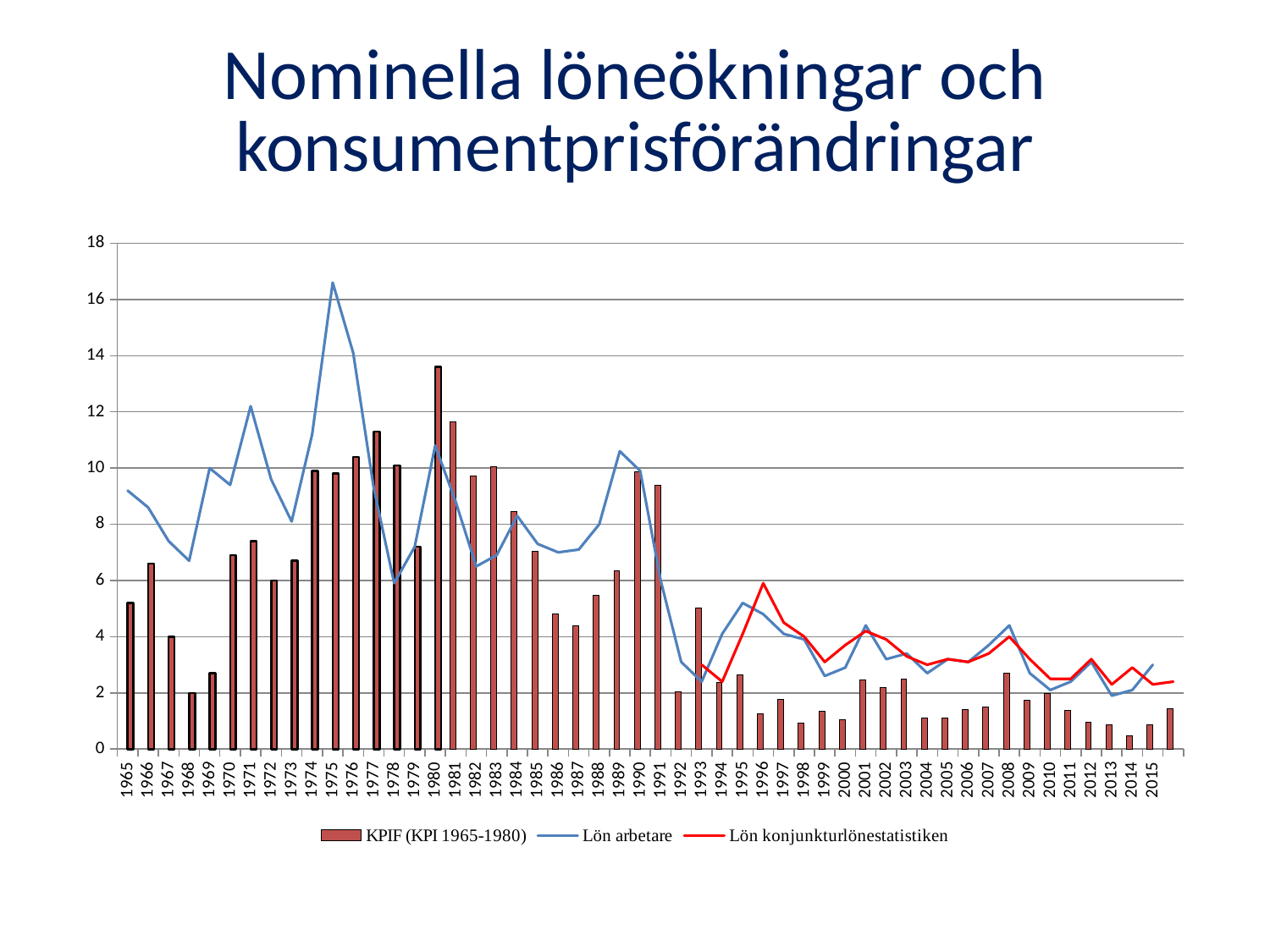
Which is larger, the KPIF (KPI 1965-1980) value for 1980 or for 1981? 1980 What is the title of the chart on the slide? Nominella löneökningar och konsumentprisförändringar What kind of chart is shown on the slide? A combined bar and line chart Which series is drawn as bars in the chart? KPIF (KPI 1965-1980) In which year is the KPIF (KPI 1965-1980) bar lowest? 2014 In which year does the Lön konjunkturlönestatistiken line reach its highest value? 1996 In which year does the Lön arbetare line reach its highest value? 1975 In which year is the KPIF (KPI 1965-1980) bar highest? 1980 Is the KPIF (KPI 1965-1980) value for 1980 greater or less than 12? greater Is the Lön arbetare value for 1975 greater or less than 16? greater Is the KPIF (KPI 1965-1980) value for 2014 greater or less than 2? less How many series does the legend list? 3